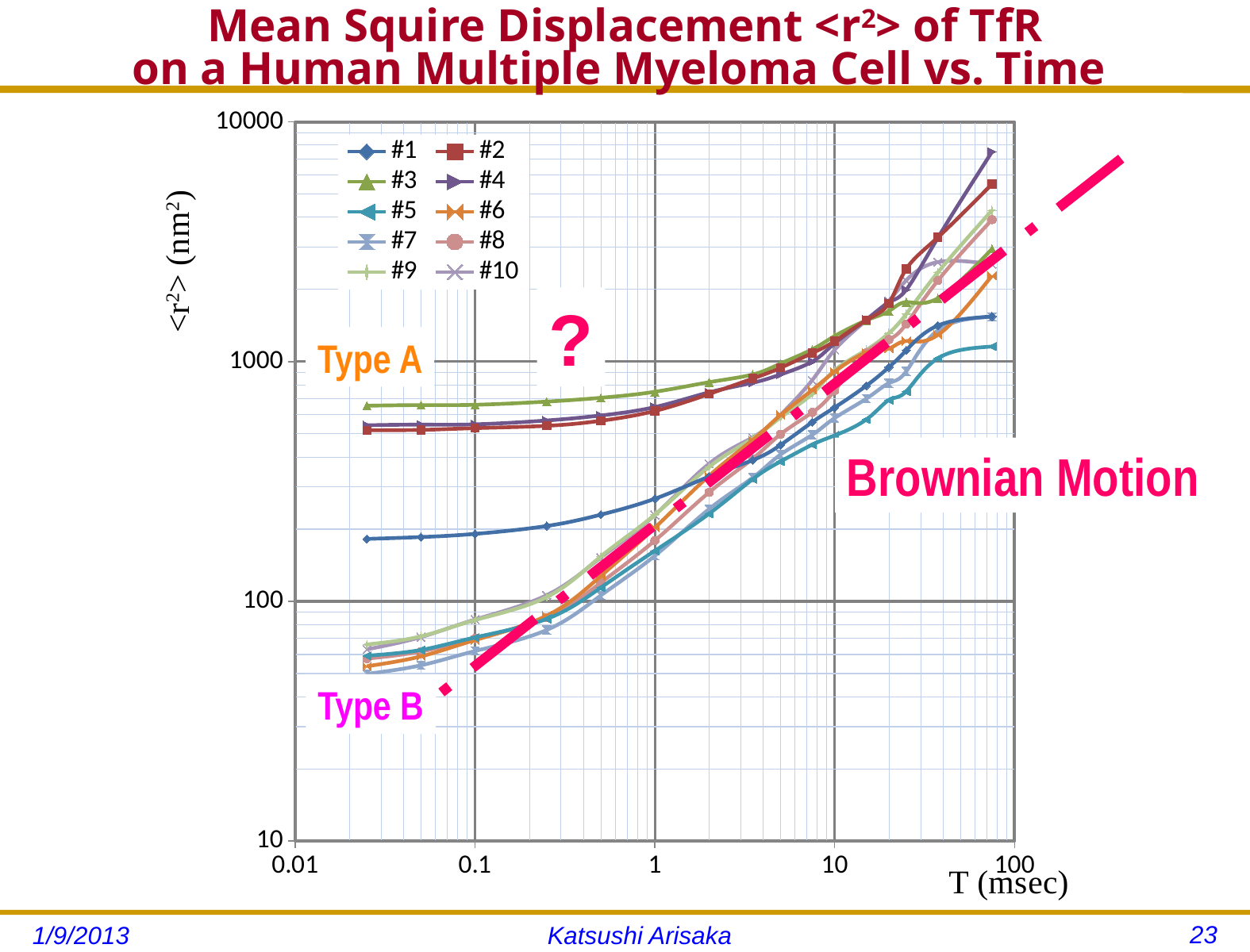
What is the label of the y axis? <r²> (nm²) Which series reaches the highest <r2> value at the largest T shown? #4 At T = 0.1 msec, is the value for series #5 greater or less than 100? less At T = 0.1 msec, is the value for series #3 greater or less than 100? greater At the largest T shown, is the value for series #4 greater or less than 1000? greater At T = 0.1 msec, which series has the larger value, #2 or #7? #2 At T = 0.1 msec, which series has the larger value, #3 or #1? #3 What kind of chart is shown on the slide? line chart Do the values of series #1 rise or fall as T increases? rise What is the label of the x axis? T (msec) How many series does the legend list? 10